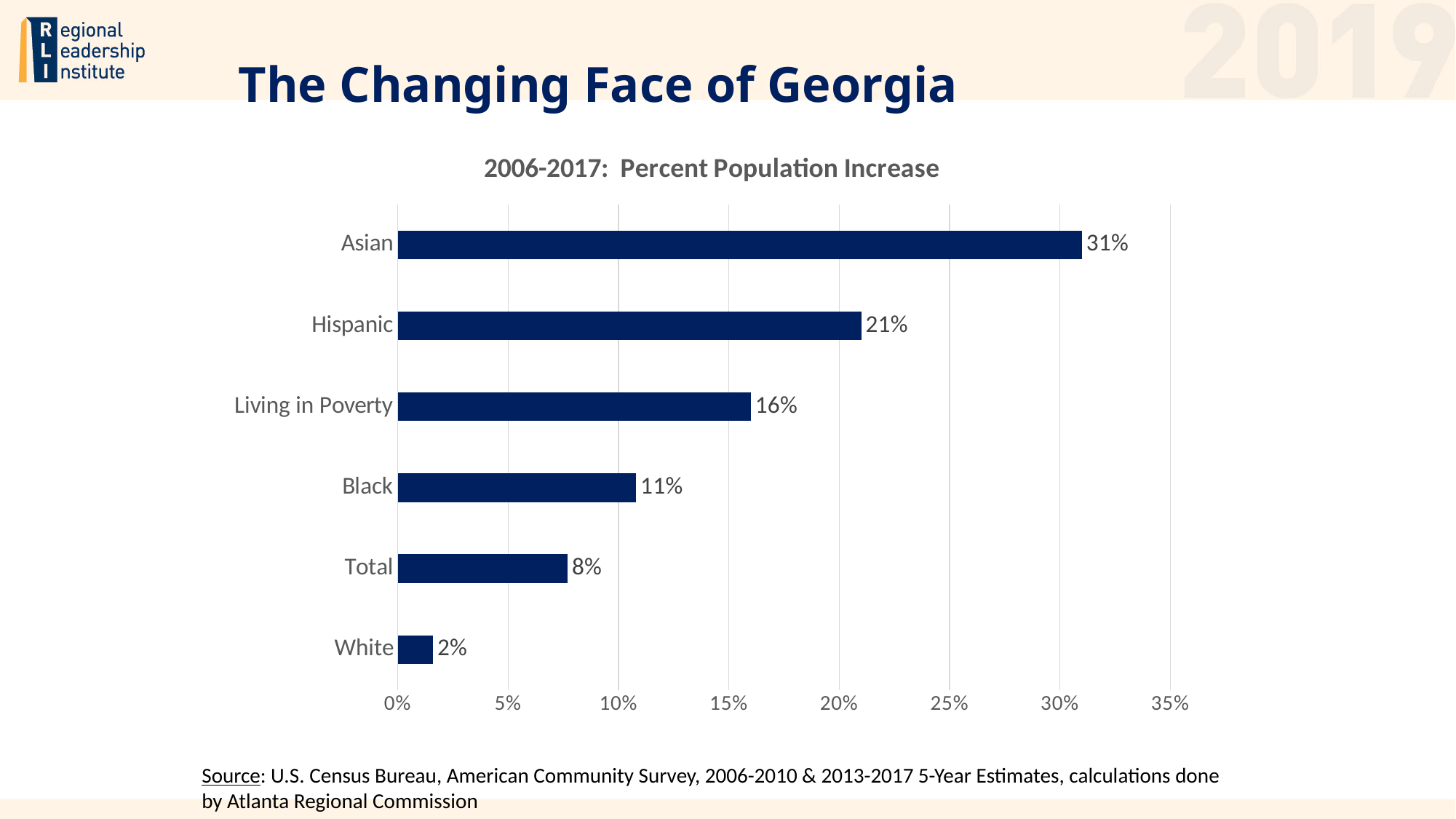
What is the title of the chart? 2006-2017: Percent Population Increase Which has a larger percent population increase, Black or Living in Poverty? Living in Poverty What is the percent population increase for Living in Poverty? 16% What is the percent population increase for White? 2% What kind of chart is shown on the slide? Bar chart Which category has the lowest percent population increase? White What is the difference between the percent population increase for Asian and for Hispanic? 10% How many categories are shown in the chart? 6 What is the percent population increase for Asian? 31% What is the percent population increase for Hispanic? 21% What is the difference between the percent population increase for Black and for Total? 3% Which category has the highest percent population increase? Asian